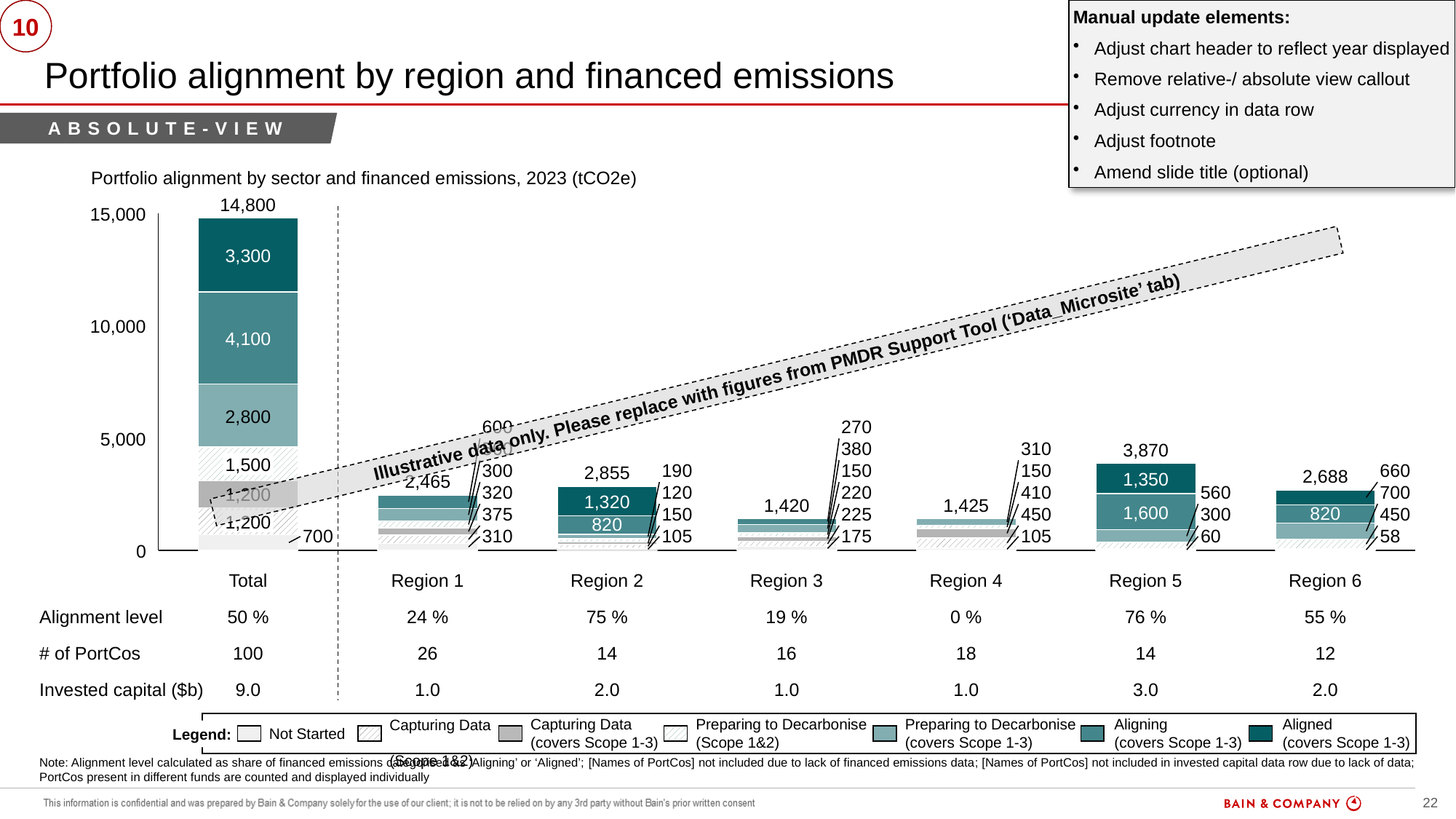
What is the difference between the totals of Region 5 and Region 2? 1,015 Which has a larger total, Region 1 or Region 6? Region 6 Is the total for Region 3 greater or less than 5,000? less Which region has the highest total financed emissions? Region 5 What is the total financed emissions value shown above the Total bar? 14,800 What is the value of the Aligning (covers Scope 1-3) segment in the Region 5 bar? 1,600 What is the total value shown above the Region 5 bar? 3,870 How many bars (categories) are shown on the x axis? 7 What kind of chart is shown on the slide? Stacked bar chart What is the value of the Aligned (covers Scope 1-3) segment in the Total bar? 3,300 How many entries does the legend list? 7 Which region has the lowest total financed emissions? Region 3